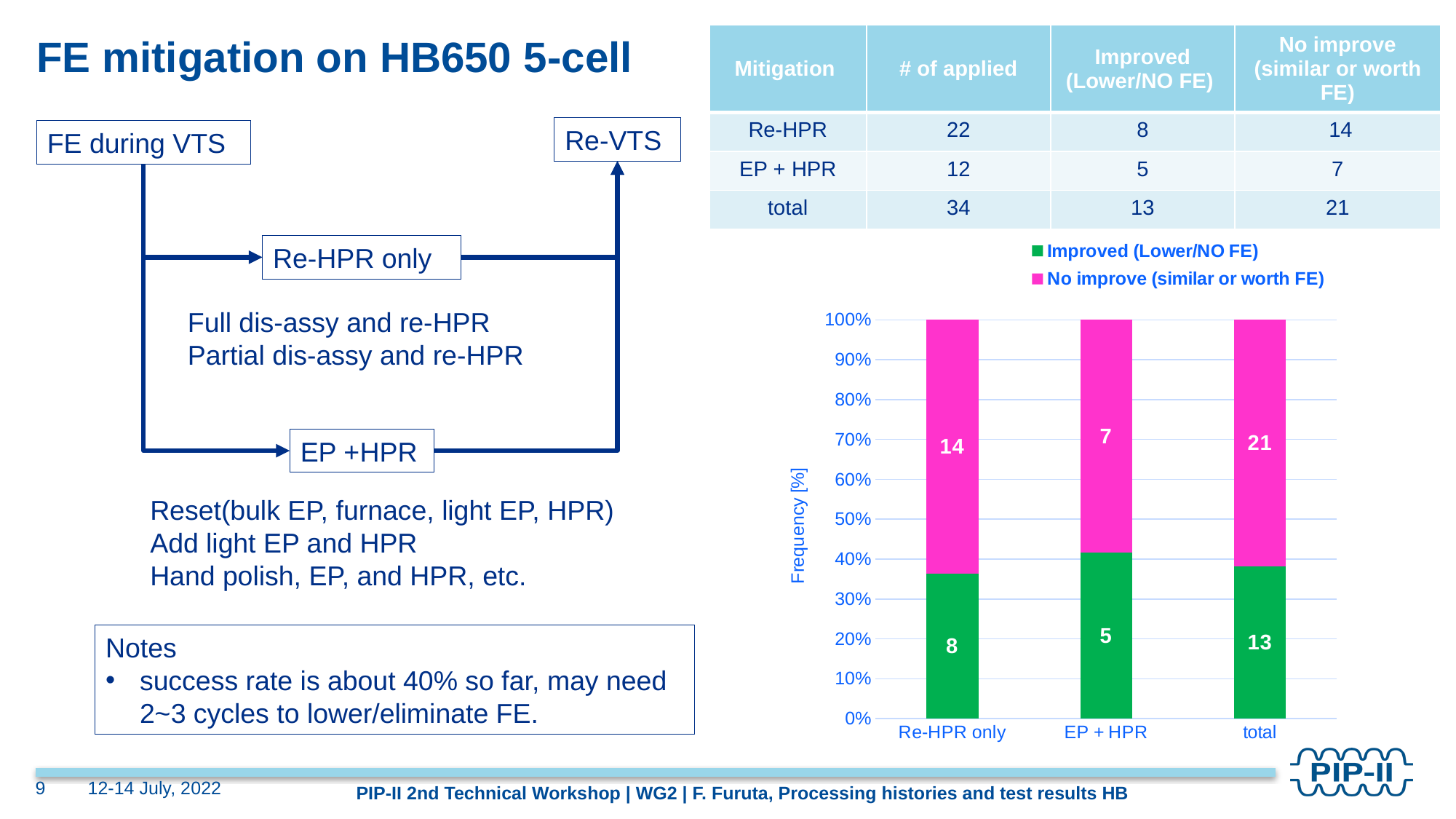
What is the sum of the two labelled values in the EP + HPR bar of the chart? 12 What kind of chart is shown on the slide? stacked bar chart What is the No improve (similar or worth FE) value for EP + HPR in the chart? 7 How many categories are shown on the x axis of the chart? 3 What is the difference between the No improve and Improved values for Re-HPR only in the chart? 6 How many series does the chart legend list? 2 Is the Improved (Lower/NO FE) share of the Re-HPR only bar greater or less than 50%? less Which category has the lowest Improved (Lower/NO FE) value in the chart? EP + HPR What is the No improve (similar or worth FE) value for total in the chart? 21 Which category has the highest No improve (similar or worth FE) value in the chart? total What is the Improved (Lower/NO FE) value for total in the chart? 13 What is the Improved (Lower/NO FE) value for Re-HPR only in the chart? 8